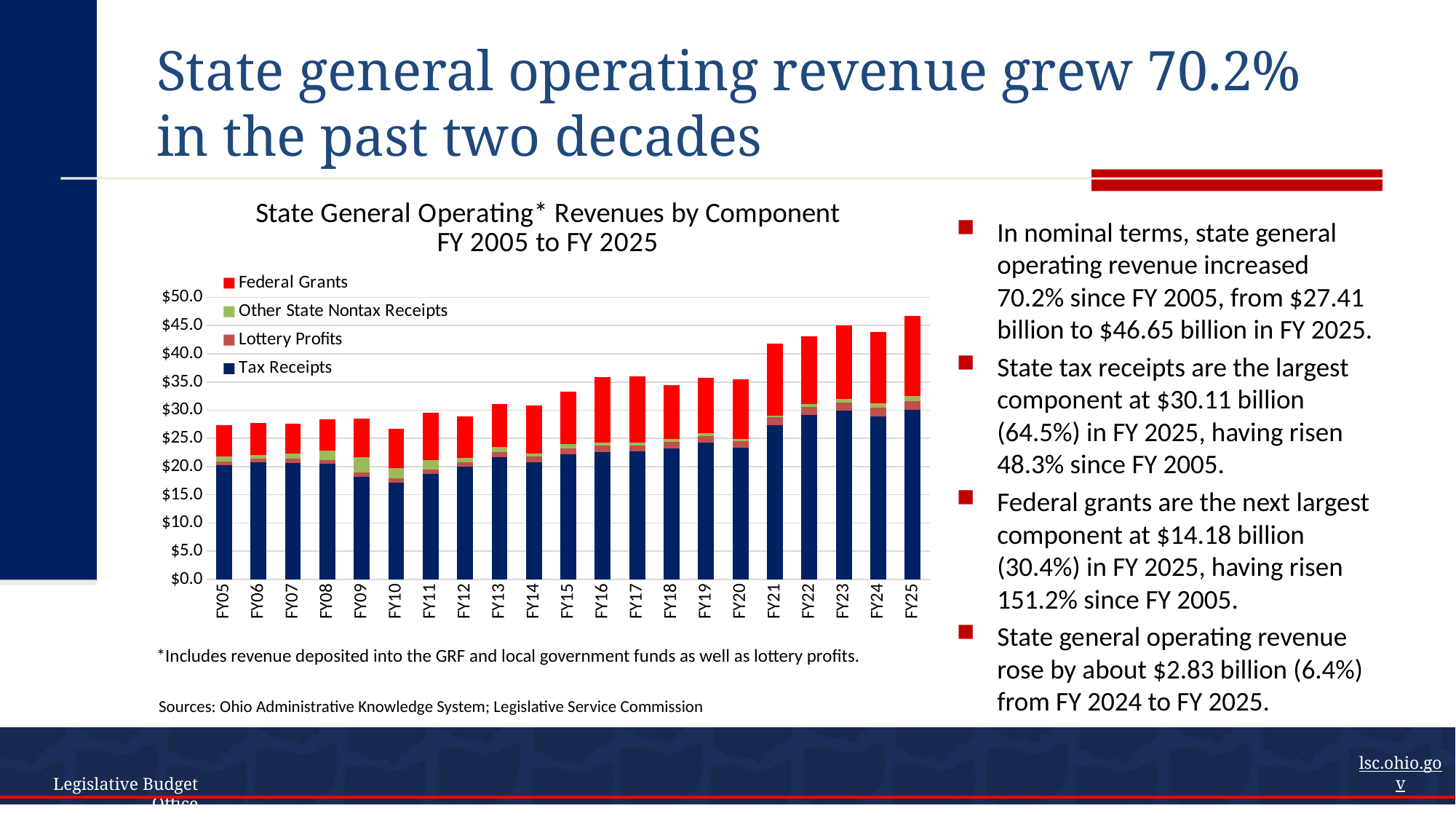
How many fiscal years are plotted along the x axis? 21 Which fiscal year has the highest total state general operating revenue? FY25 Which series is shown in red in the chart? Federal Grants Which has the larger total bar, FY22 or FY20? FY22 Which has the larger Tax Receipts segment, FY25 or FY10? FY25 How many series does the chart legend list? 4 Is the total bar for FY21 greater or less than $40.0? greater Is the Tax Receipts segment for FY09 greater or less than $20.0? less Overall, do total revenues rise or fall from FY05 to FY25? Rise What kind of chart is shown on the slide? Stacked bar chart Is the total bar for FY05 greater or less than $30.0? less